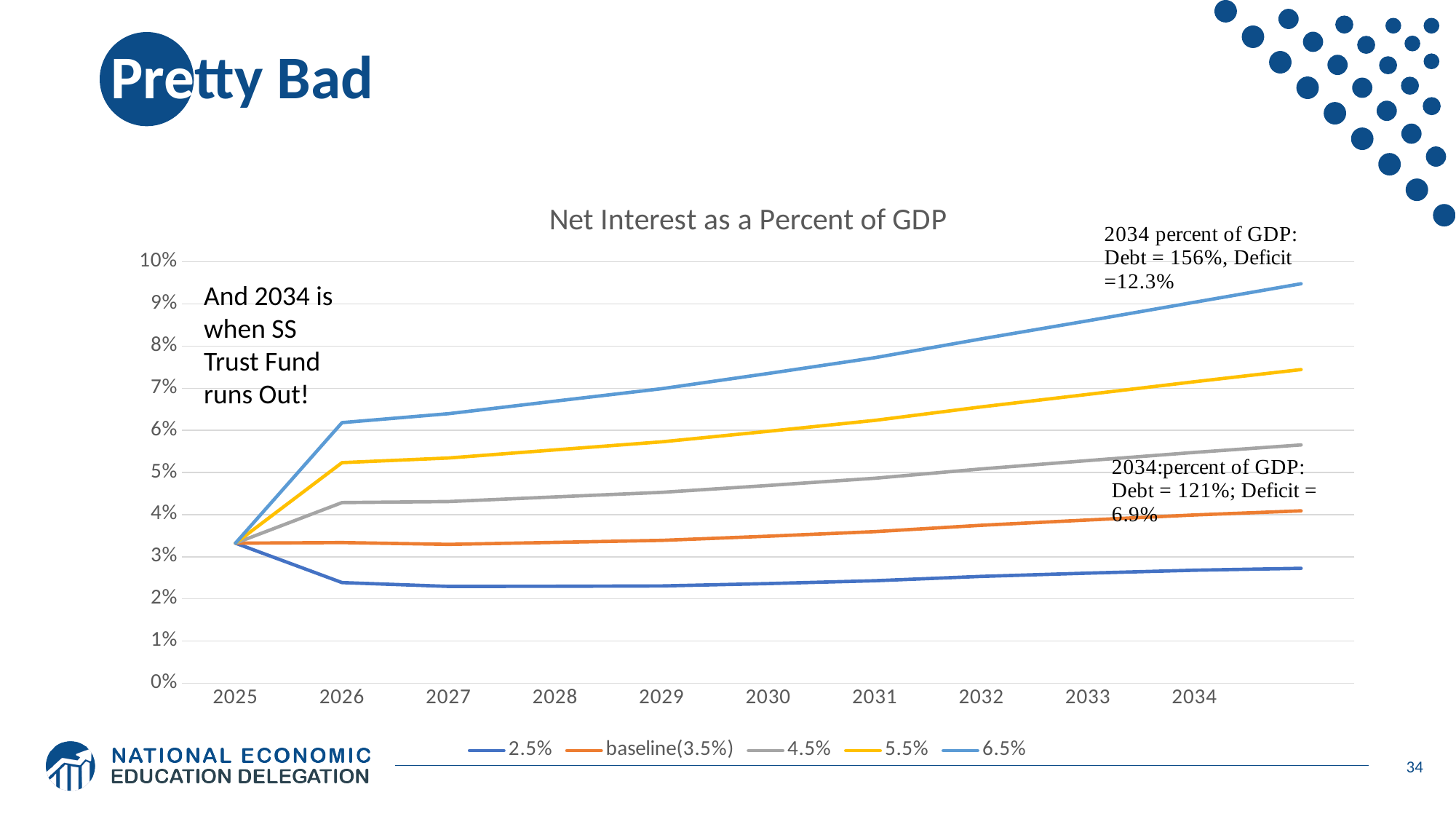
Which series has the highest value in 2034? 6.5% Does the 6.5% series rise or fall from 2025 to 2034? rise Which series has the lowest value in 2034? 2.5% What is the title of the chart? Net Interest as a Percent of GDP How many years are labelled on the x axis? 10 Is the value for the 6.5% series in 2034 greater or less than 8%? greater In 2030, which series has the larger value, 5.5% or 4.5%? 5.5% Is the value for the 5.5% series in 2034 greater or less than 6%? greater Is the value for the 2.5% series in 2027 greater or less than 3%? less What kind of chart is shown on the slide? line chart How many series does the legend list? 5